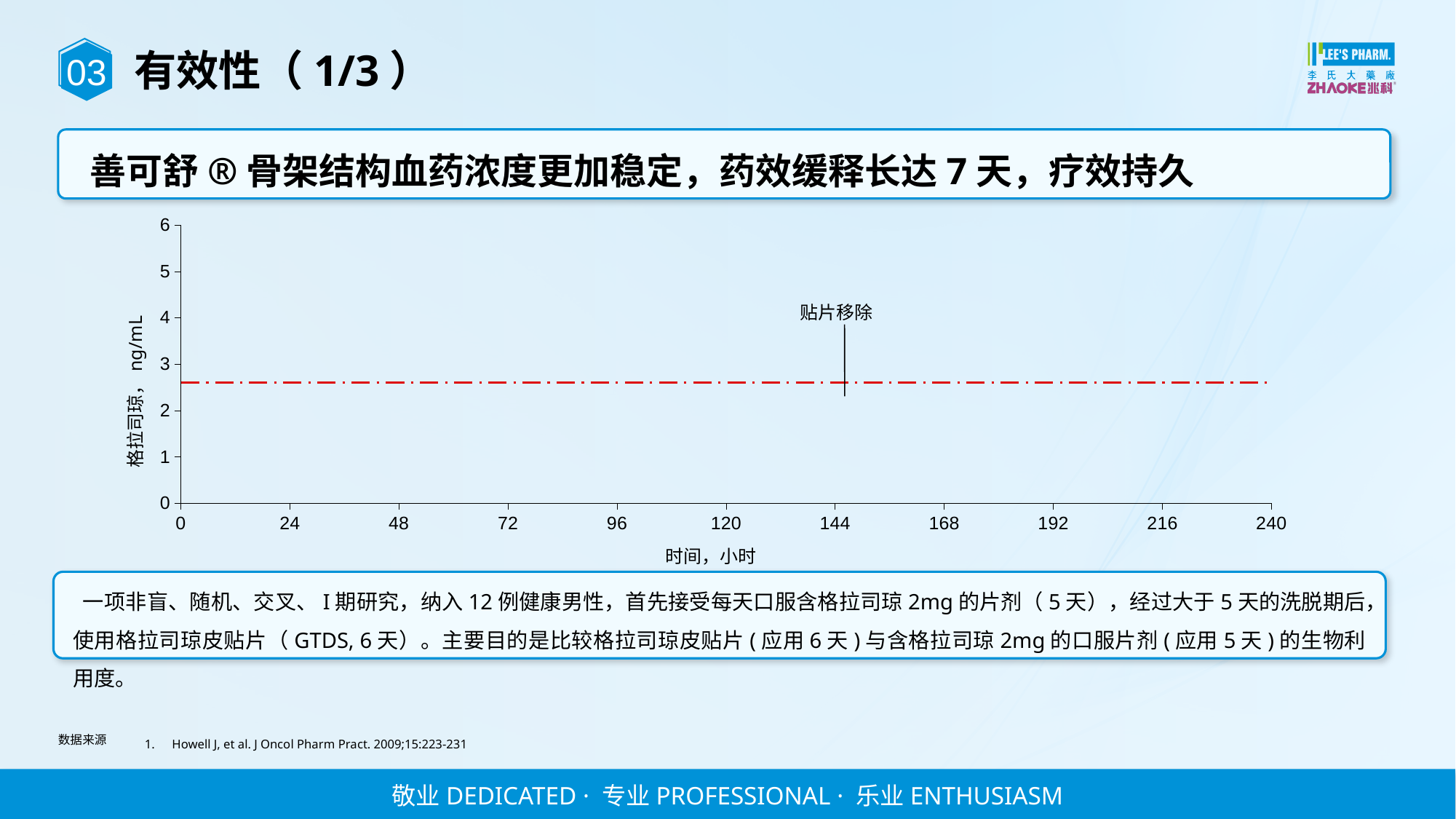
Is the value of the red dashed line greater or less than 3 ng/mL? less What is the label of the x axis of the chart? 时间，小时 What is the interval between consecutive tick labels on the x axis? 24 What is the label of the y axis of the chart? 格拉司琼，ng/mL Is the value of the red dashed line greater or less than 2 ng/mL? greater How many tick labels are shown on the x axis of the chart? 11 What is the maximum value shown on the x axis of the chart? 240 Does the red dashed line rise, fall, or stay flat as time increases along the x axis? stays flat What is the maximum value shown on the y axis of the chart? 6 What kind of chart is shown on the slide? line chart